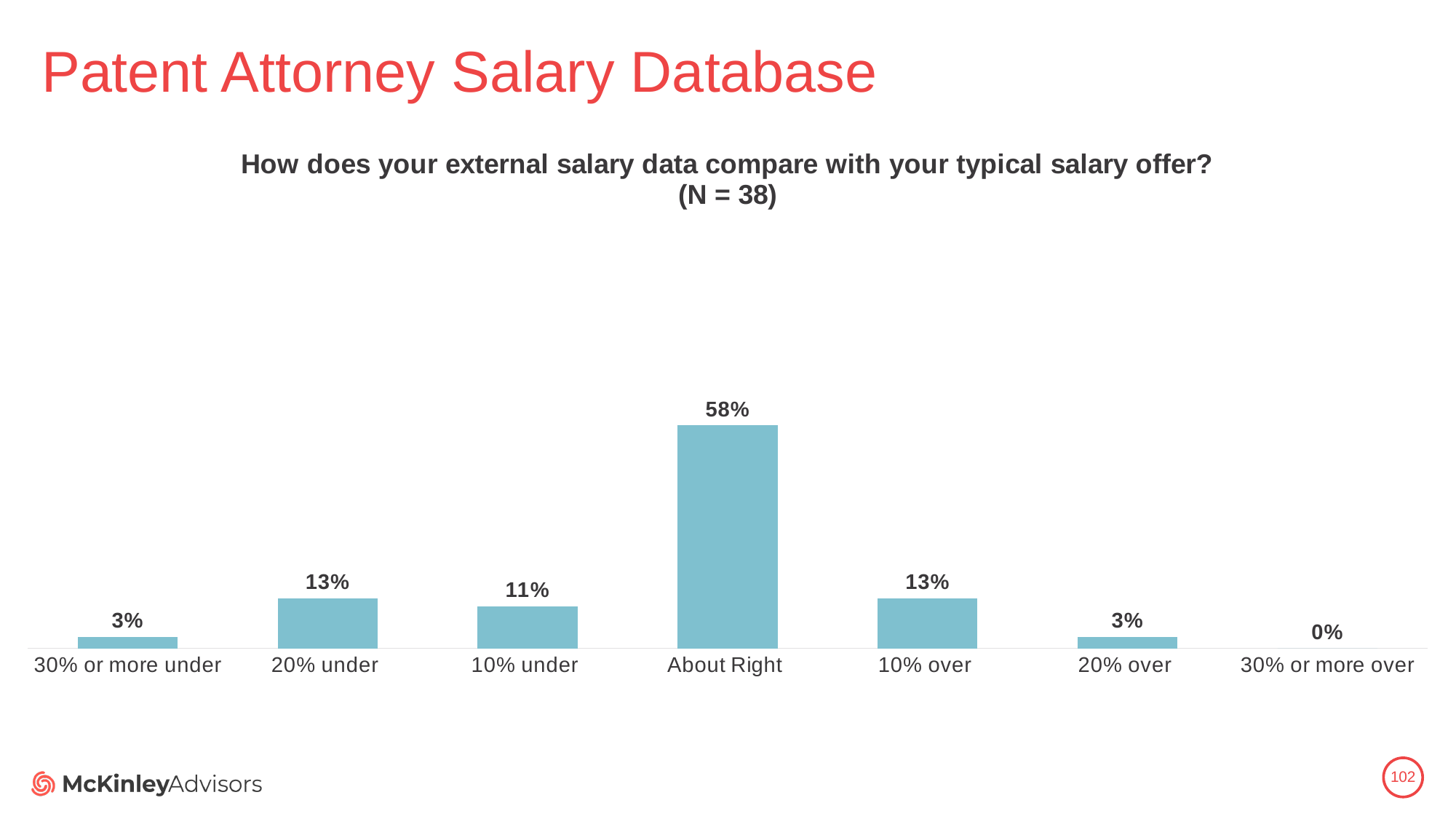
Which category has the lowest value? 30% or more over What is the difference between the values for '20% under' and '10% under'? 2% How many categories are shown on the x axis? 7 What kind of chart is shown on the slide? Bar chart What is the difference between the values for 'About Right' and '10% over'? 45% Which category has the highest value? About Right What percentage of respondents said their external salary data is 'About Right' compared with their typical salary offer? 58% What is the value for '10% under'? 11% What is the value for '20% under'? 13% What is the value for '30% or more over'? 0% What is the sample size (N) stated in the chart title? 38 Which is larger, the value for '10% under' or the value for '10% over'? 10% over